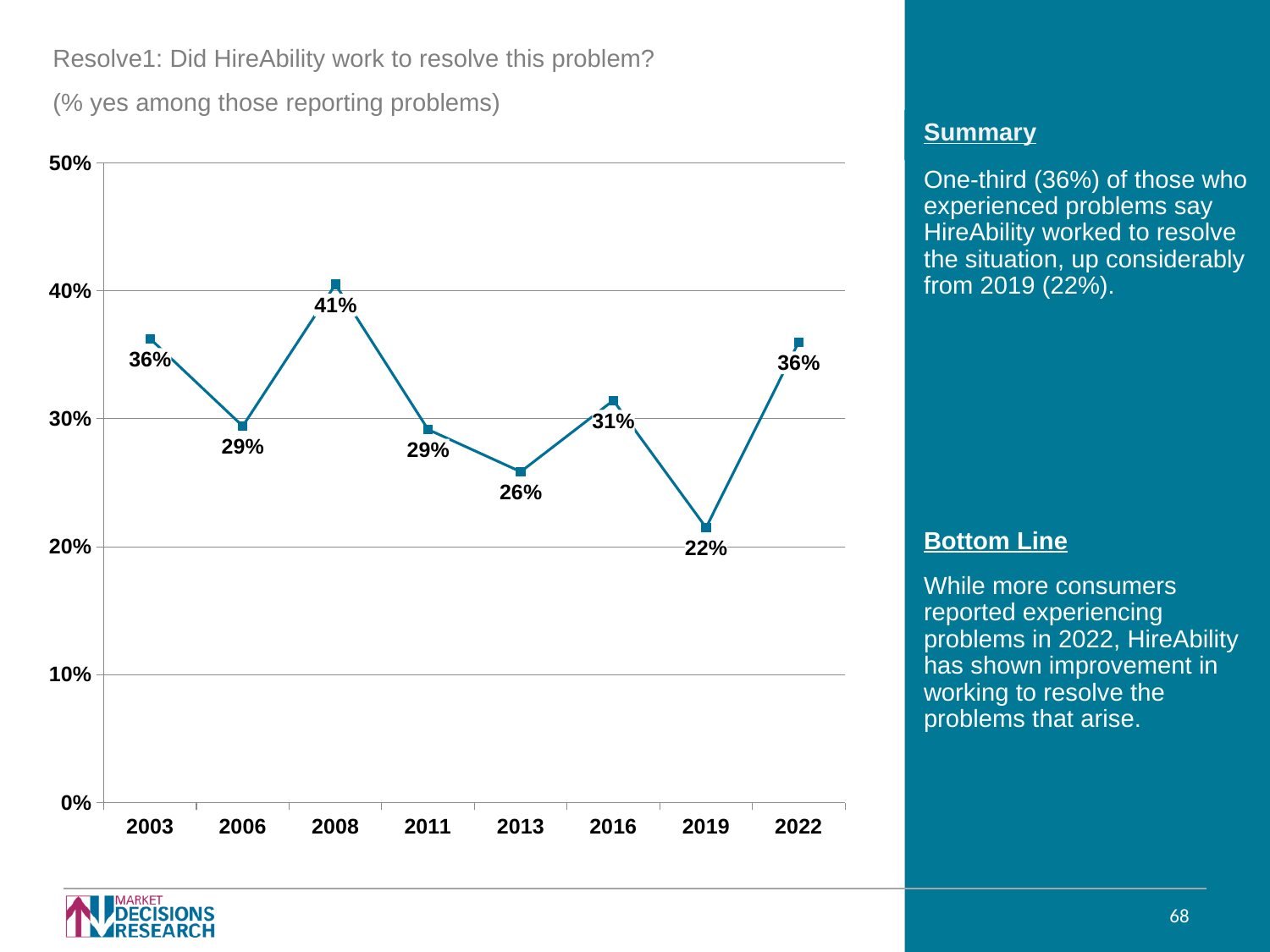
Which year has the highest value? 2008 Is the value for 2008 greater or less than 40%? greater Did the value rise or fall from 2019 to 2022? Rise What is the highest value shown on the y axis? 50% What is the value for 2019? 22% Which year has the lowest value? 2019 What percentage is shown for 2008? 41% What is the difference between the 2022 value and the 2019 value? 14 percentage points What kind of chart is shown? Line chart What is the value for 2022? 36% How many years are plotted on the x axis? 8 Which is larger, the value for 2013 or the value for 2016? 2016